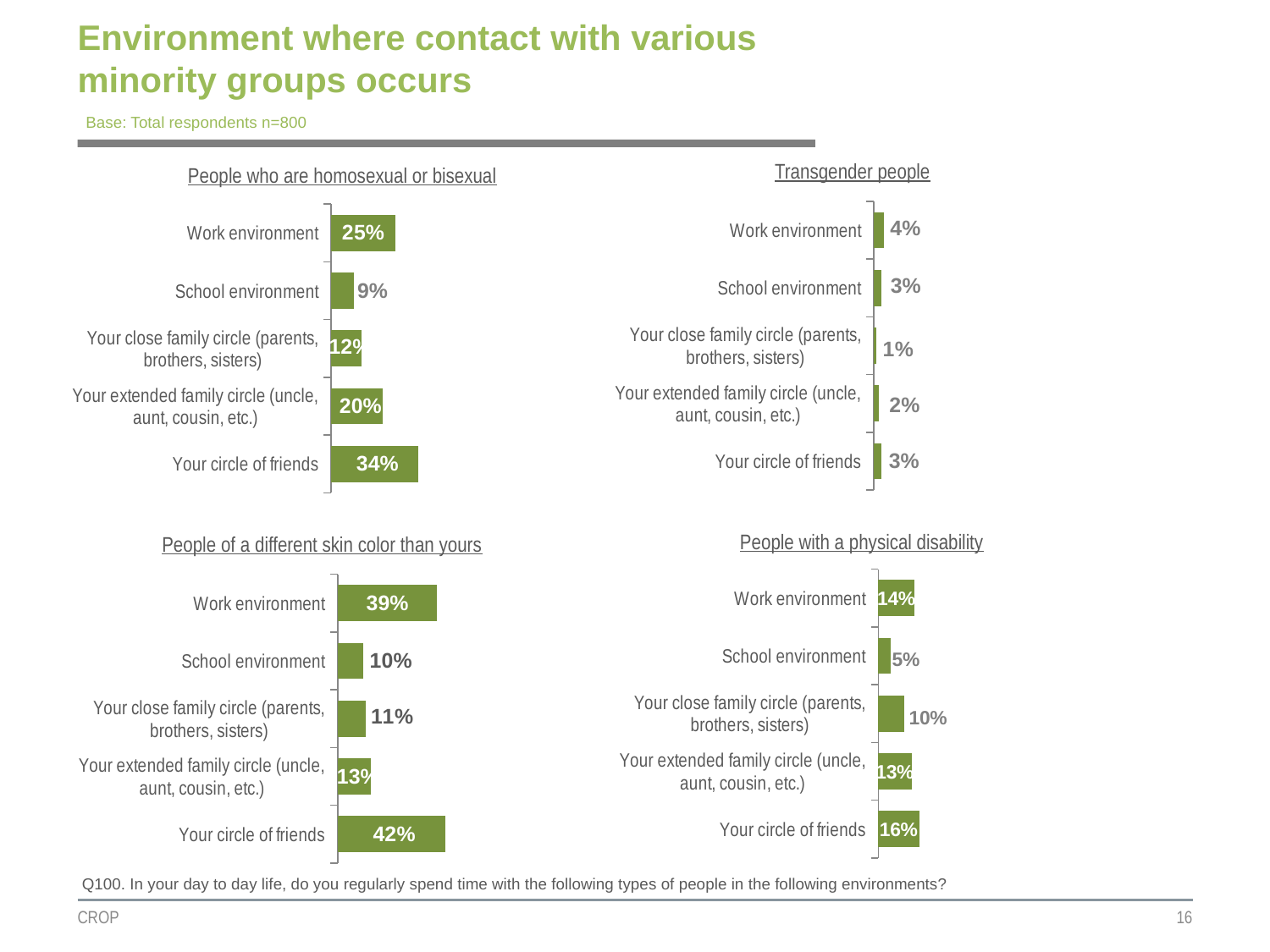
In the 'People of a different skin color than yours' chart, what is the difference between Your circle of friends and Work environment? 3% How many categories does the 'People with a physical disability' chart show? 5 In the 'People who are homosexual or bisexual' chart, what is the value for Work environment? 25% In the 'People of a different skin color than yours' chart, what is the value for School environment? 10% How many charts are shown on the slide? 4 In the 'People who are homosexual or bisexual' chart, what is the difference between Your circle of friends and School environment? 25% In the 'People who are homosexual or bisexual' chart, which category has the highest value? Your circle of friends In the 'People with a physical disability' chart, which is larger: Work environment or Your circle of friends? Your circle of friends In the 'Transgender people' chart, what is the value for Work environment? 4% In the 'People with a physical disability' chart, what is the value for Your close family circle (parents, brothers, sisters)? 10% In the 'Transgender people' chart, which category has the lowest value? Your close family circle (parents, brothers, sisters) What kind of chart is the 'Transgender people' chart? Bar chart